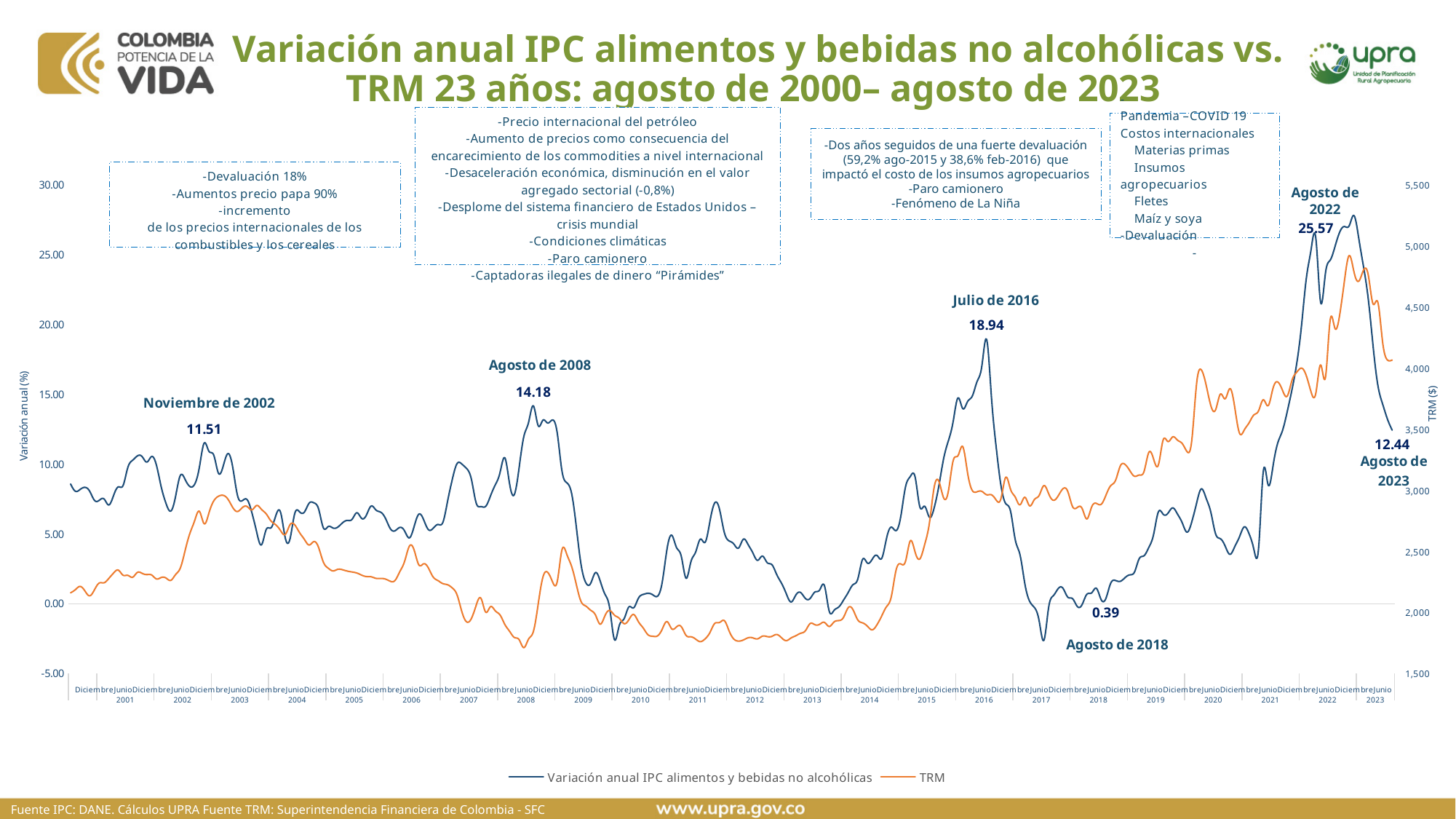
What is the labelled value of the IPC annual variation in Julio de 2016? 18.94 What is the difference between the labelled IPC values for Agosto de 2022 and Agosto de 2023? 13.13 What is the labelled value of the IPC annual variation in Agosto de 2023? 12.44 What is the label of the right-hand vertical axis? TRM ($) Which labelled point on the IPC line has the lowest value? Agosto de 2018 What is the labelled value of the IPC annual variation in Agosto de 2022? 25.57 Which labelled point on the IPC line has the highest value? Agosto de 2022 What is the labelled value of the IPC annual variation in Agosto de 2018? 0.39 Is the TRM value at its 2022 peak greater or less than 4,500? greater Which labelled IPC value is larger, Julio de 2016 or Agosto de 2008? Julio de 2016 What kind of chart is shown on the slide? line chart How many series does the legend list? 2